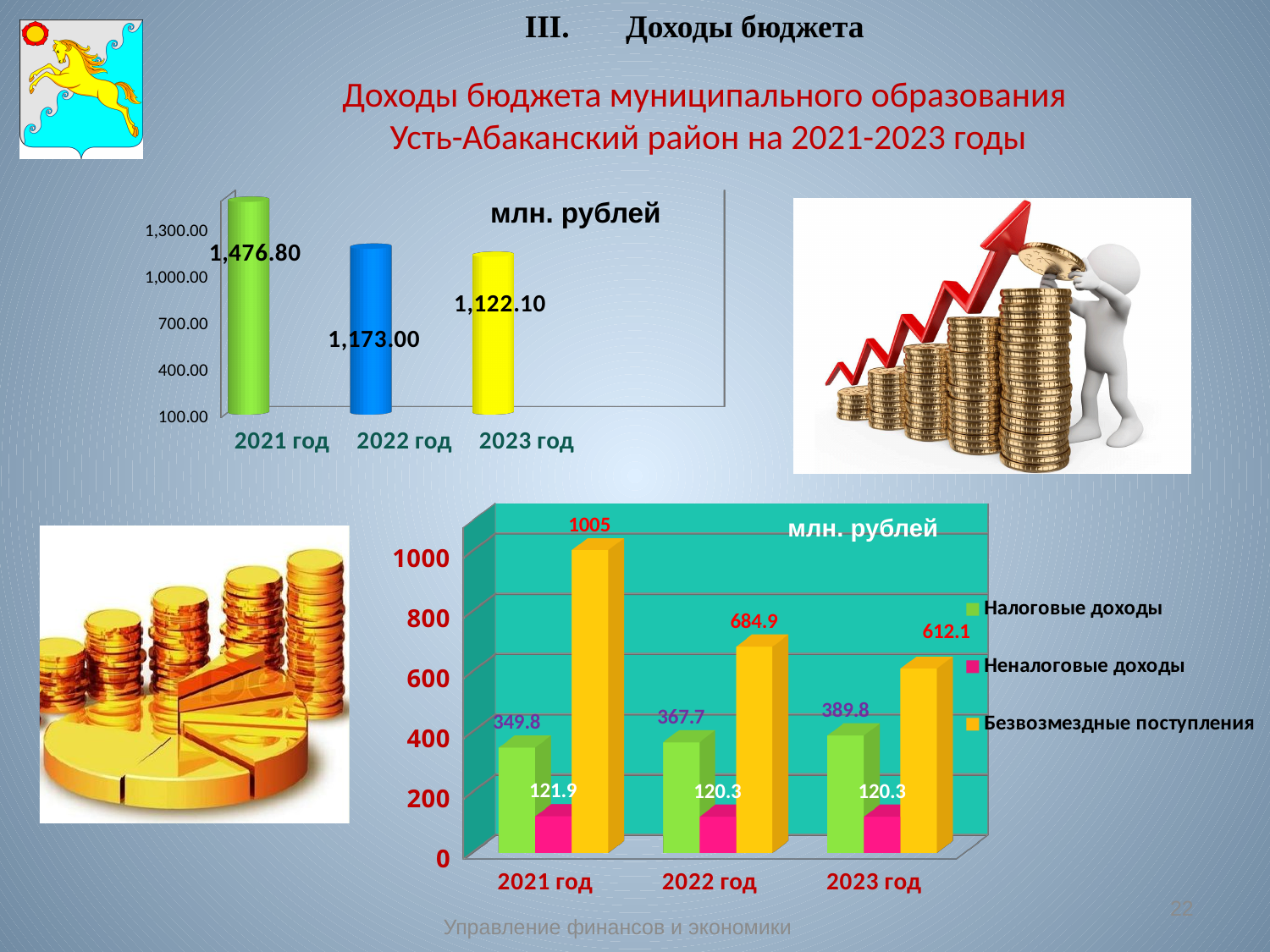
In the top-left chart, what is the difference between the values for 2021 год and 2022 год? 303.80 In the top-left chart, which year has the highest value? 2021 год In the top-left chart, do the values rise or fall from 2021 год to 2023 год? fall In the bottom chart, how many series does the legend list? 3 What kind of chart is the bottom chart? bar chart In the bottom chart, what is the value of Налоговые доходы for 2023 год? 389.8 In the top-left chart, what is the value for 2023 год? 1,122.10 In the top-left chart, how many years are shown? 3 In the bottom chart, what is the value of Безвозмездные поступления for 2021 год? 1005 In the top-left chart, what is the value for 2021 год? 1,476.80 In the bottom chart, which is larger for 2022 год: Налоговые доходы or Безвозмездные поступления? Безвозмездные поступления In the bottom chart, what is the value of Неналоговые доходы for 2022 год? 120.3